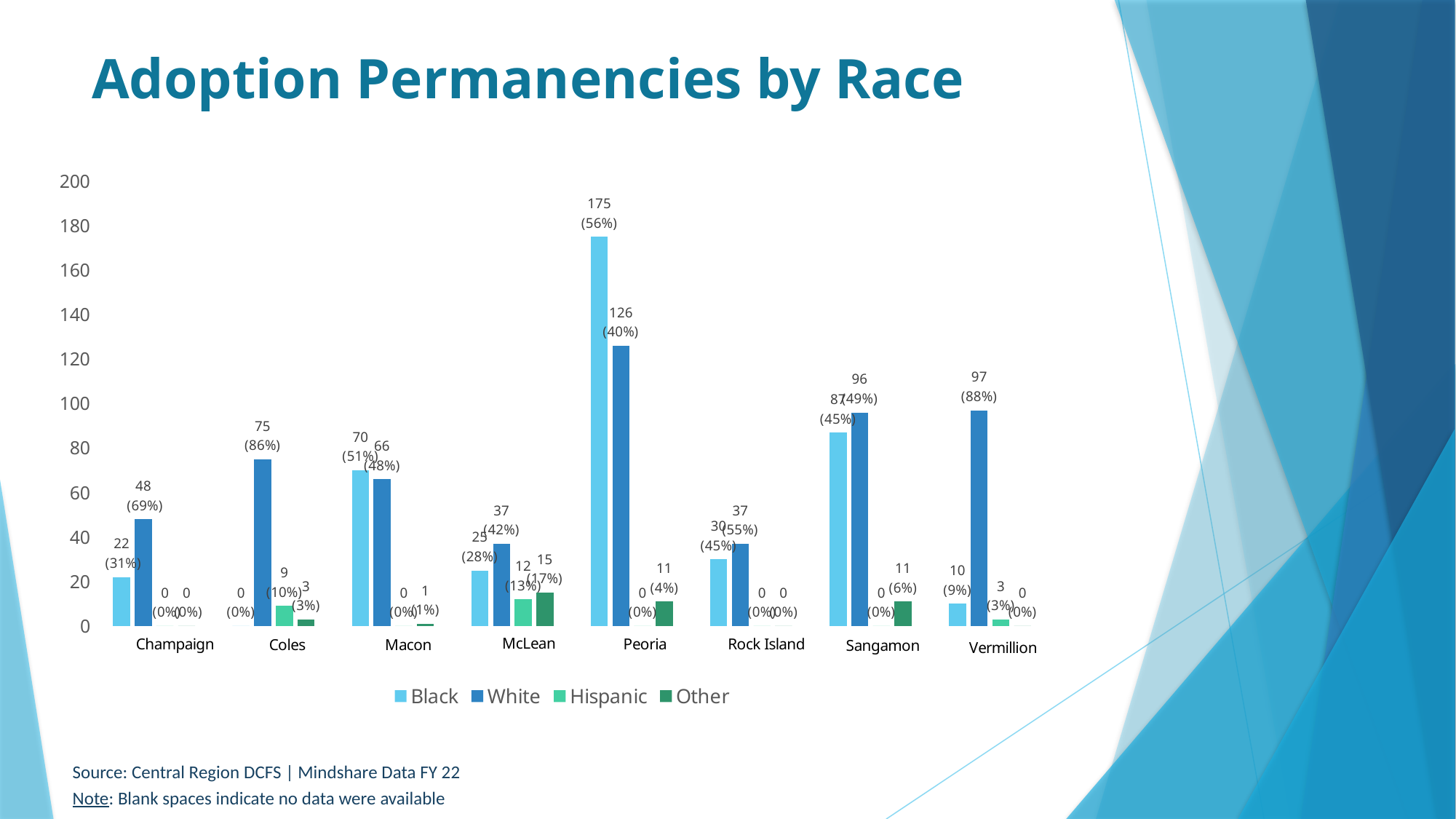
What is the difference between the Black and White values in Peoria? 49 How many counties are shown on the x axis? 8 What is the value for White in Vermillion? 97 What is the title of the chart? Adoption Permanencies by Race Which is larger in Macon, the Black value or the White value? Black Which county has the highest value for Black? Peoria Which county has the lowest value for White? McLean and Rock Island (37) What is the value for Black in Peoria? 175 How many series does the legend list? 4 What kind of chart is shown on the slide? Bar chart What is the value for Other in Sangamon? 11 What is the value for Hispanic in McLean? 12